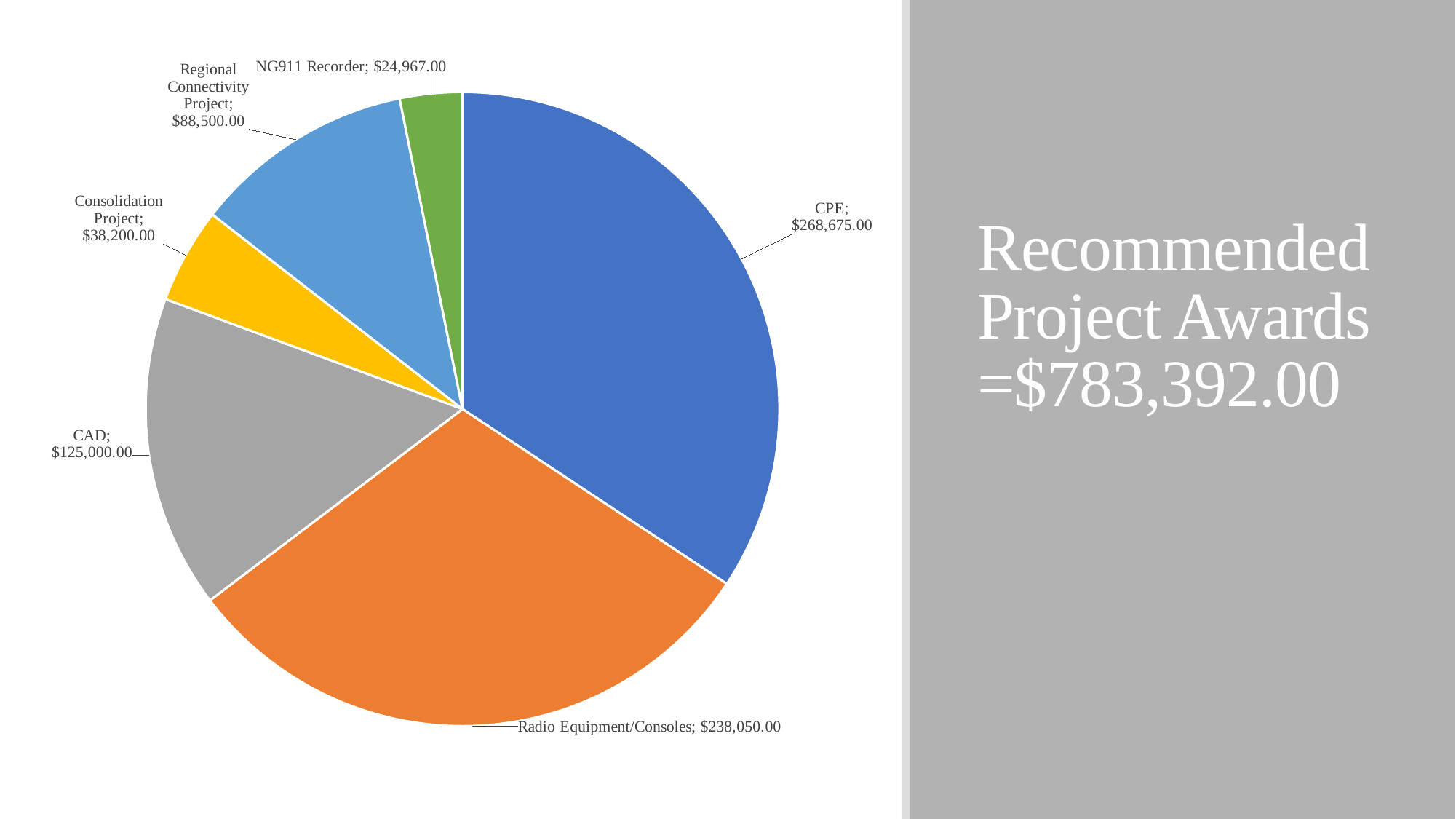
What total amount of recommended project awards is stated on the slide? $783,392.00 What is the value for the Regional Connectivity Project? $88,500.00 How many categories are shown in the pie chart? 6 What type of chart is shown on the slide? Pie chart Which category has the largest slice of the pie? CPE What is the value for the NG911 Recorder? $24,967.00 What is the value for Radio Equipment/Consoles? $238,050.00 Which is larger, the value for CAD or the value for the Regional Connectivity Project? CAD What is the difference between the CAD value and the Consolidation Project value? $86,800.00 What is the difference between the CPE value and the Radio Equipment/Consoles value? $30,625.00 Which category has the smallest slice of the pie? NG911 Recorder What is the value for CPE? $268,675.00